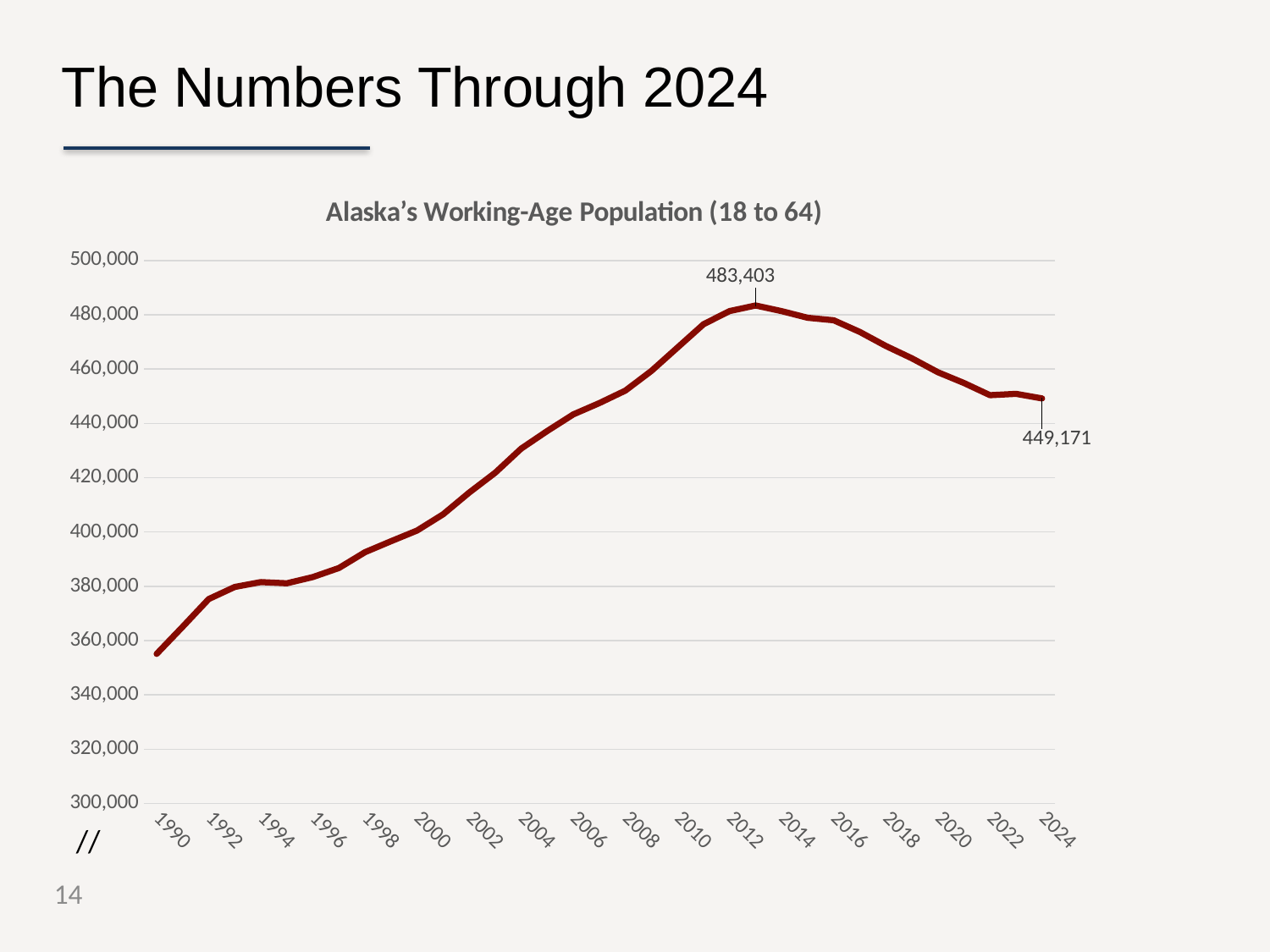
What is the highest value labelled on the chart? 483,403 Is the value for 1990 greater or less than 360,000? less What is the title of the chart? Alaska's Working-Age Population (18 to 64) Is the value for 2010 greater or less than 460,000? greater Is the value for 1994 greater or less than 400,000? less What kind of chart is shown on the slide? line chart Does the working-age population rise or fall between 2014 and 2024? fall How many year labels are shown on the x axis? 18 What is Alaska's working-age population in 2024 according to the chart? 449,171 Which year has the larger working-age population, 1990 or 2024? 2024 What is the difference between the peak value of 483,403 and the 2024 value of 449,171? 34,232 Does the working-age population rise or fall between 1990 and 2012? rise